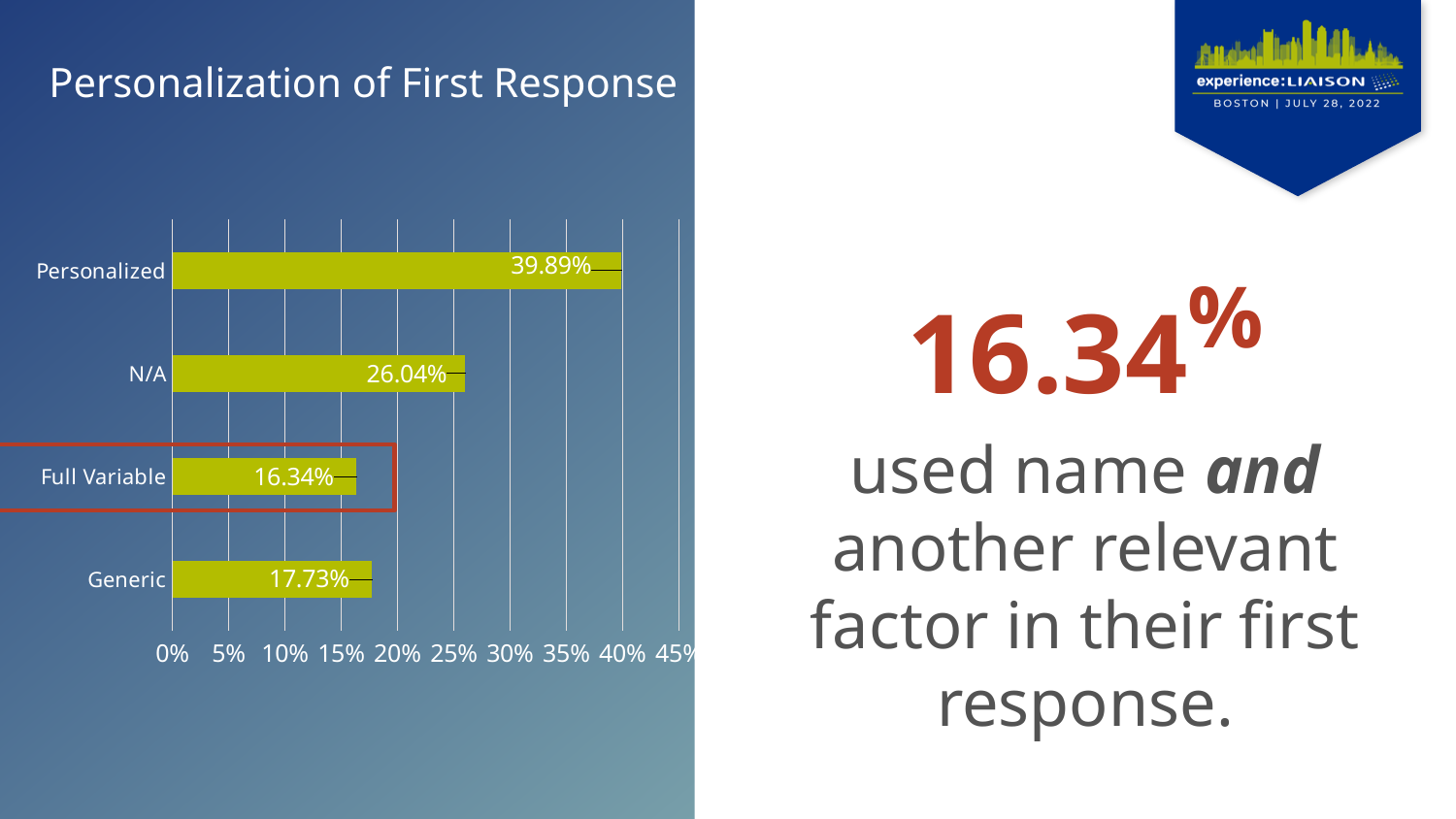
What is the value for Full Variable? 16.34% What is the value for Generic? 17.73% What is the difference between the values for Personalized and N/A? 13.85% How many categories are shown in the chart? 4 Which category has the highest value? Personalized What kind of chart is shown on the slide? Bar chart What is the title of the chart? Personalization of First Response Which category has the lowest value? Full Variable What is the value for Personalized? 39.89% What is the value for N/A? 26.04% Which is larger, the value for Generic or the value for Full Variable? Generic Is the value for N/A greater or less than 25%? greater